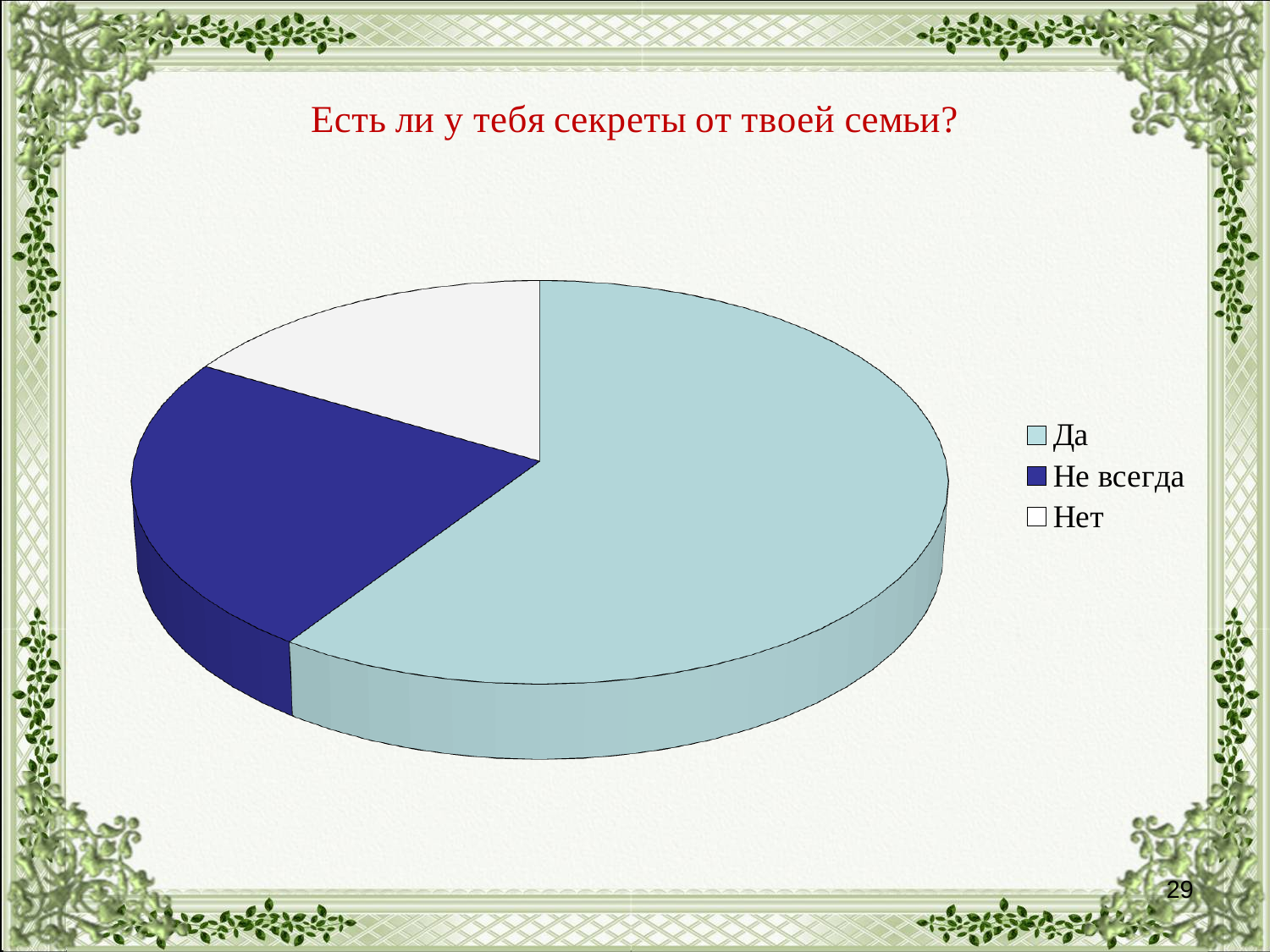
Which category has the largest slice of the pie? Да What is the title of the chart? Есть ли у тебя секреты от твоей семьи? How many slices does the pie chart have? 3 Does the Да slice take up more or less than half of the pie? More Which slice is larger, Не всегда or Нет? Не всегда How many entries does the legend list? 3 Which slice is larger, Да or Не всегда? Да Which category is shown in dark blue in the legend? Не всегда What kind of chart is shown on the slide? Pie chart Which category has the smallest slice of the pie? Нет